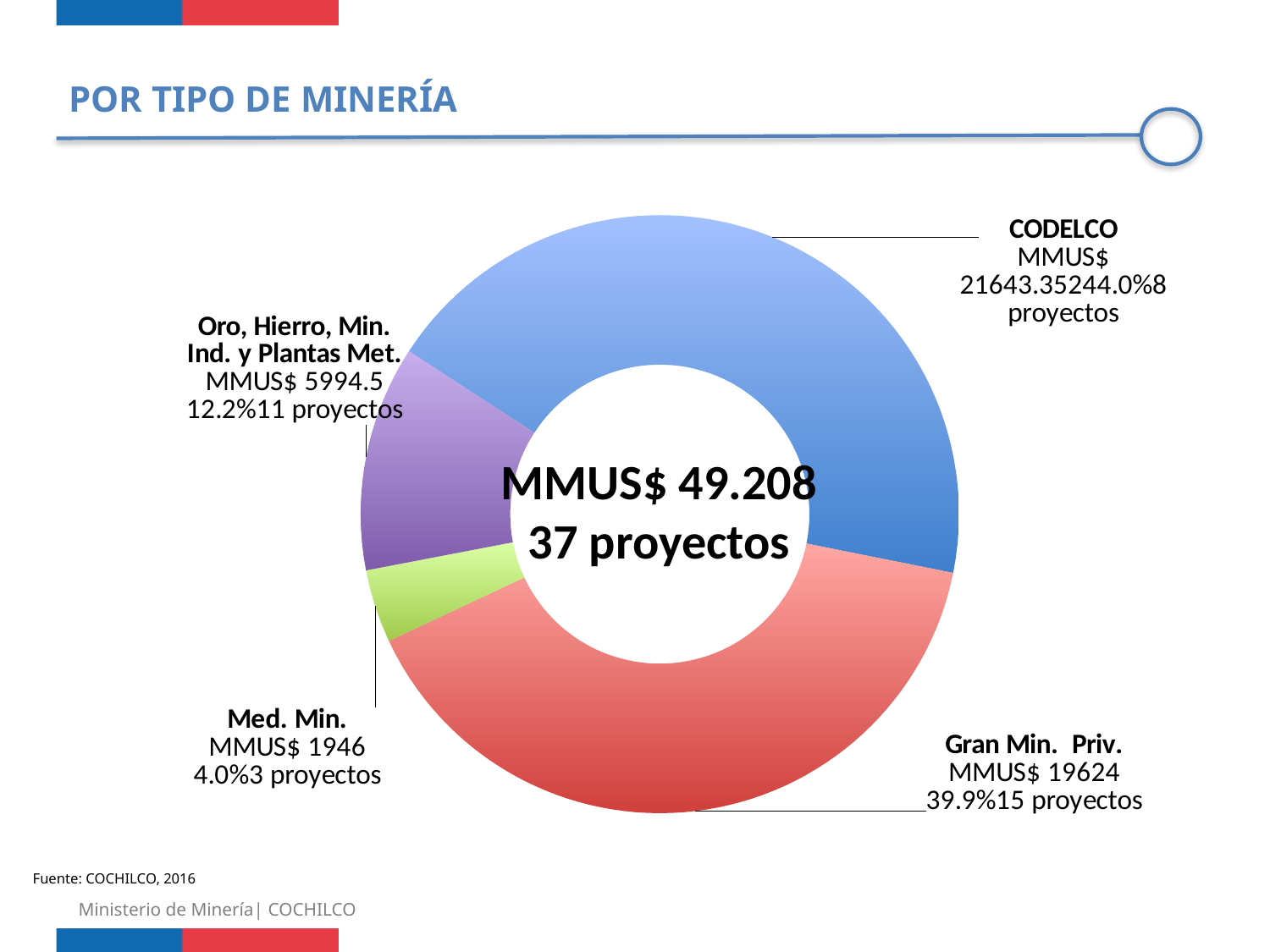
What is the difference between the investment for Gran Min. Priv. and Med. Min.? MMUS$ 17678 What is the investment value shown for Oro, Hierro, Min. Ind. y Plantas Met.? MMUS$ 5994.5 What total investment and number of projects are shown in the centre of the chart? MMUS$ 49.208, 37 proyectos What kind of chart is shown on the slide? Doughnut (pie) chart How many projects are listed for Gran Min. Priv.? 15 proyectos What share of the total does Gran Min. Priv. represent? 39.9% Which category has the smallest share of the doughnut chart? Med. Min. What share of the total does Med. Min. represent? 4.0% Which is larger, the investment for Oro, Hierro, Min. Ind. y Plantas Met. or for Med. Min.? Oro, Hierro, Min. Ind. y Plantas Met. What is the investment value shown for Med. Min.? MMUS$ 1946 What is the investment value shown for Gran Min. Priv.? MMUS$ 19624 How many segments does the doughnut chart have? 4